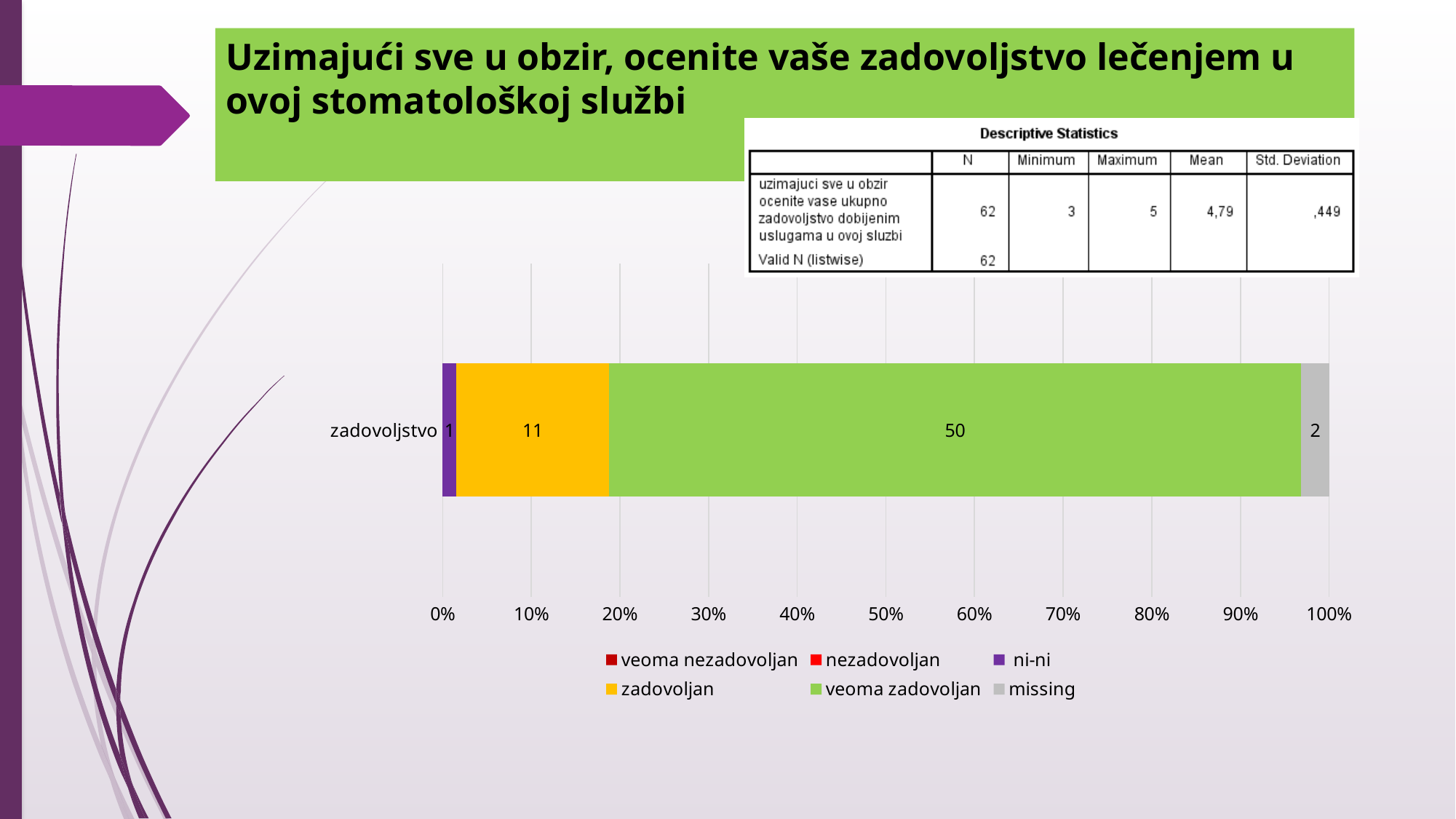
What is the value for the 'ni-ni' segment of the 'zadovoljstvo' bar? 1 Which labelled series has the smallest value in the 'zadovoljstvo' bar? ni-ni How many series does the legend list? 6 What colour is the 'veoma zadovoljan' segment? green What is the difference between the 'veoma zadovoljan' and 'zadovoljan' values? 39 What kind of chart is shown on the slide? bar chart Which is larger, the 'zadovoljan' value or the 'missing' value? zadovoljan Which series has the largest value in the 'zadovoljstvo' bar? veoma zadovoljan What is the total of all labelled segments in the 'zadovoljstvo' bar? 64 What is the value for the 'missing' segment of the 'zadovoljstvo' bar? 2 What is the value for the 'veoma zadovoljan' segment of the 'zadovoljstvo' bar? 50 What is the value for the 'zadovoljan' segment of the 'zadovoljstvo' bar? 11